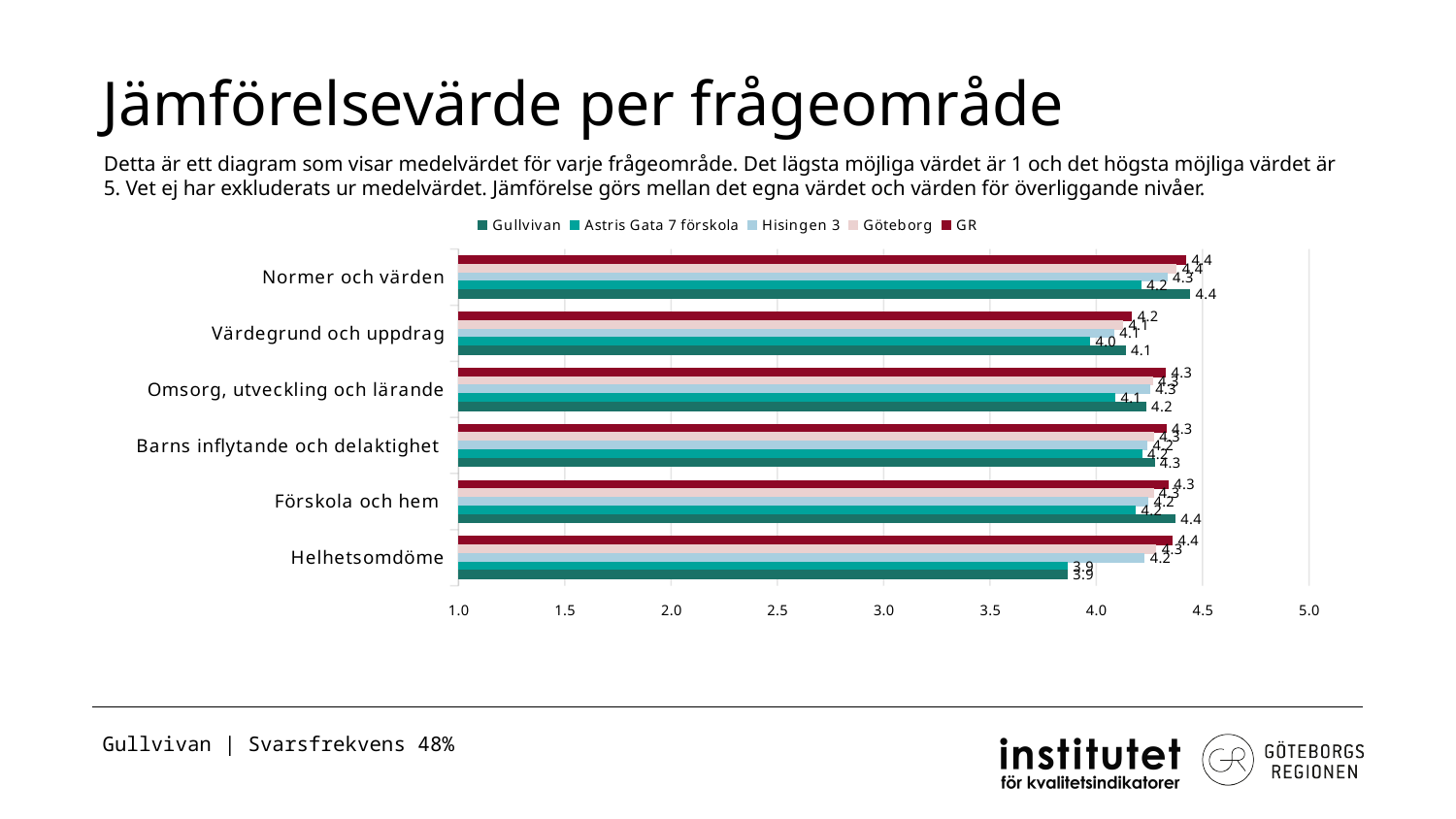
Which is larger in the category Helhetsomdöme: the value for GR or the value for Gullvivan? GR Is the value for Astris Gata 7 förskola in the category Helhetsomdöme greater or less than 4.0? less What is the value for Astris Gata 7 förskola in the category Värdegrund och uppdrag? 4.0 What kind of chart is shown on the slide? Bar chart How many series does the legend list? 5 What is the value for Gullvivan in the category Normer och värden? 4.4 What is the first series listed in the legend? Gullvivan What is the difference between Gullvivan and Astris Gata 7 förskola in the category Normer och värden? 0.2 How many question areas (categories) are shown on the y axis? 6 What is the value for Gullvivan in the category Helhetsomdöme? 3.9 Which category has the lowest value for Gullvivan? Helhetsomdöme What is the value for GR in the category Helhetsomdöme? 4.4